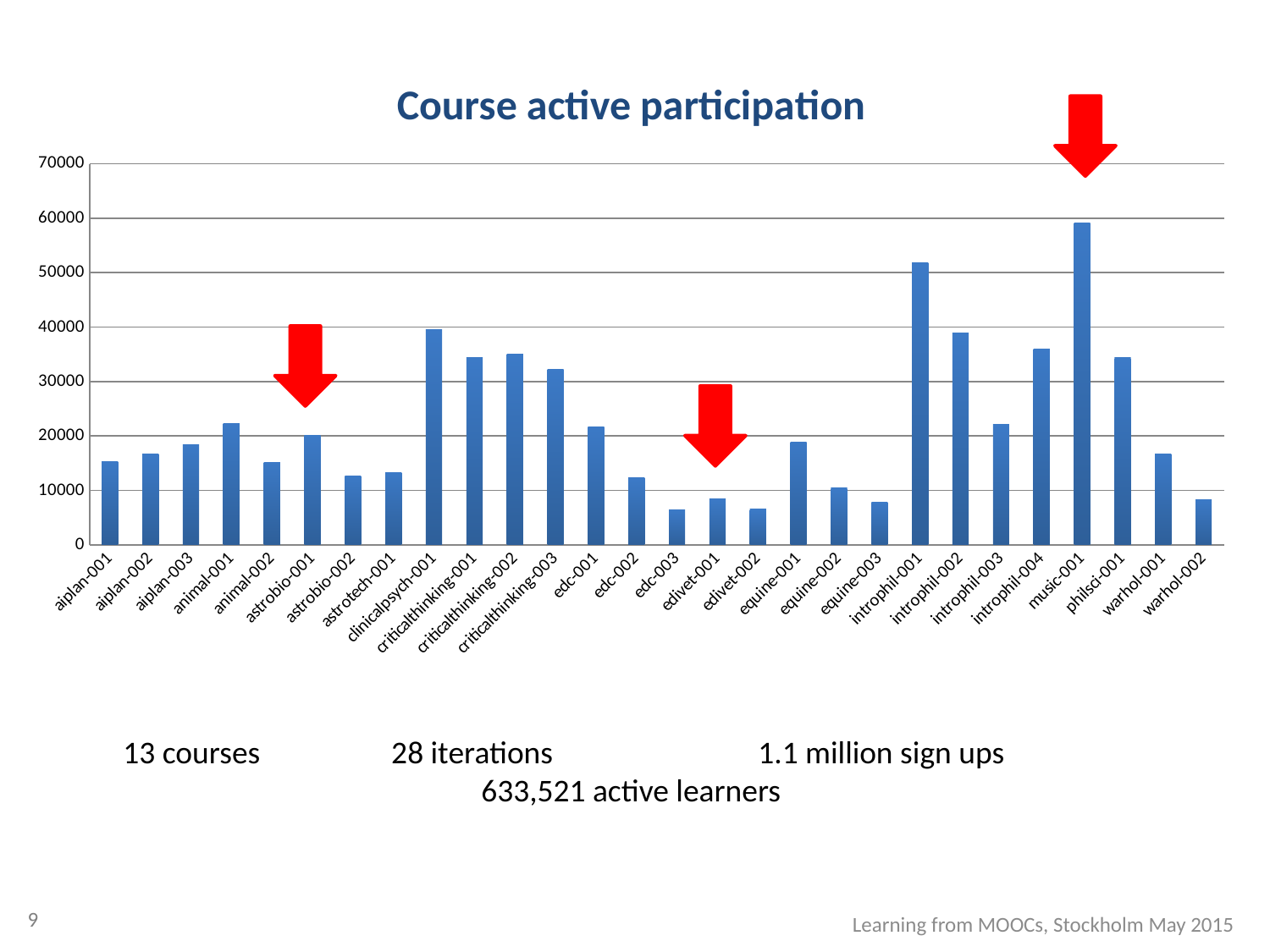
Which has the larger value, introphil-001 or introphil-002? introphil-001 What is the title of the chart? Course active participation Is the value for edc-003 greater or less than 10000? less Is the value for clinicalpsych-001 greater or less than 30000? greater Which course iteration has the highest active participation? music-001 Which has the larger value, edc-001 or edc-002? edc-001 How many course iterations (bars) are plotted in the chart? 28 Is the value for warhol-002 greater or less than 10000? less Do the values rise or fall from aiplan-001 to aiplan-003? rise What kind of chart is shown on the slide? bar chart